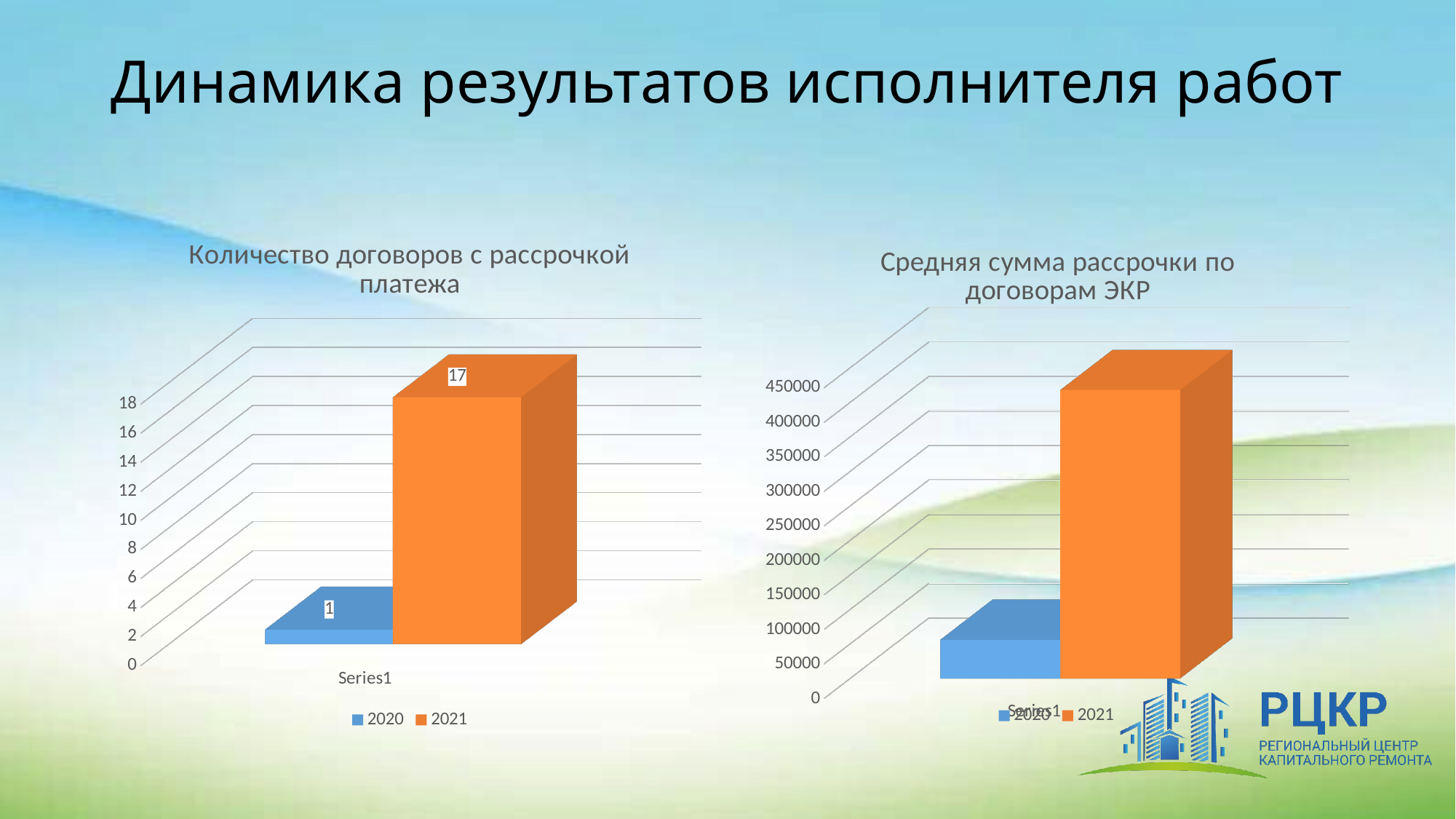
On the chart 'Количество договоров с рассрочкой платежа', what is the value for 2020? 1 On the chart 'Средняя сумма рассрочки по договорам ЭКР', is the value for 2020 greater or less than 150000? less On the chart 'Средняя сумма рассрочки по договорам ЭКР', how many series does the legend list? 2 On the chart 'Количество договоров с рассрочкой платежа', which series has the higher value, 2020 or 2021? 2021 On the chart 'Количество договоров с рассрочкой платежа', what is the value for 2021? 17 What is the title of the right chart on the slide? Средняя сумма рассрочки по договорам ЭКР On the chart 'Количество договоров с рассрочкой платежа', what is the difference between the 2021 and 2020 values? 16 On the chart 'Средняя сумма рассрочки по договорам ЭКР', which series has the larger value, 2020 or 2021? 2021 What kind of chart is the left chart, 'Количество договоров с рассрочкой платежа'? Bar chart On the chart 'Количество договоров с рассрочкой платежа', which colour represents the 2021 series? Orange On the chart 'Количество договоров с рассрочкой платежа', how many series does the legend list? 2 On the chart 'Средняя сумма рассрочки по договорам ЭКР', is the value for 2021 greater or less than 300000? greater